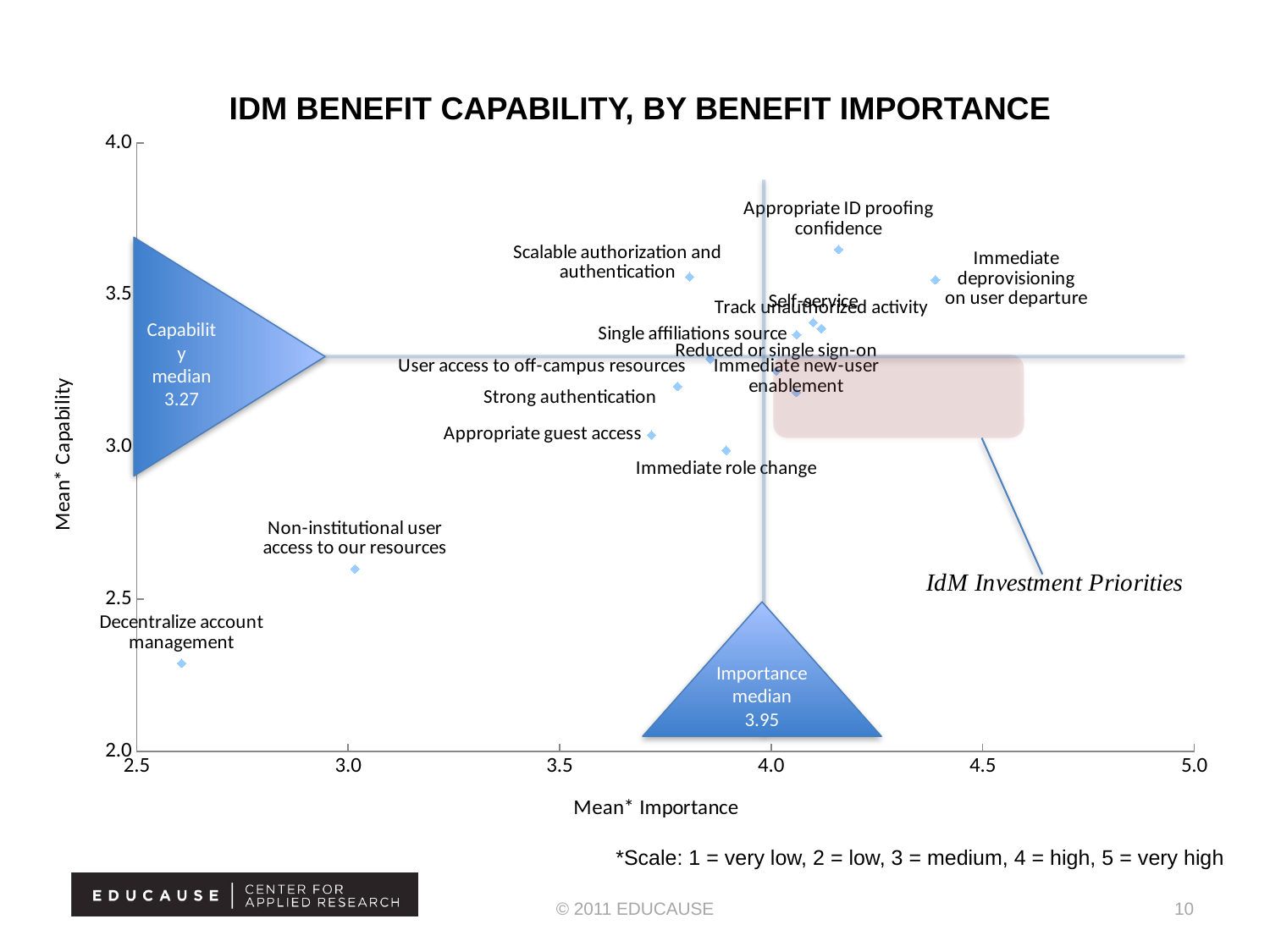
Which benefit has the lowest mean importance? Decentralize account management Which has the higher mean capability, Appropriate guest access or Non-institutional user access to our resources? Appropriate guest access What is the Importance median value shown on the chart? 3.95 What is the title of the chart's horizontal axis? Mean* Importance Is the mean importance for Immediate deprovisioning on user departure greater or less than 4.0? greater What kind of chart is shown on the slide? scatter chart Is the mean importance for Non-institutional user access to our resources greater or less than 3.5? less Which benefit has the highest mean importance? Immediate deprovisioning on user departure Is the mean capability for Decentralize account management greater or less than 2.5? less What is the Capability median value shown on the chart? 3.27 Which benefit has the lowest mean capability? Decentralize account management Which benefit has the highest mean capability? Appropriate ID proofing confidence